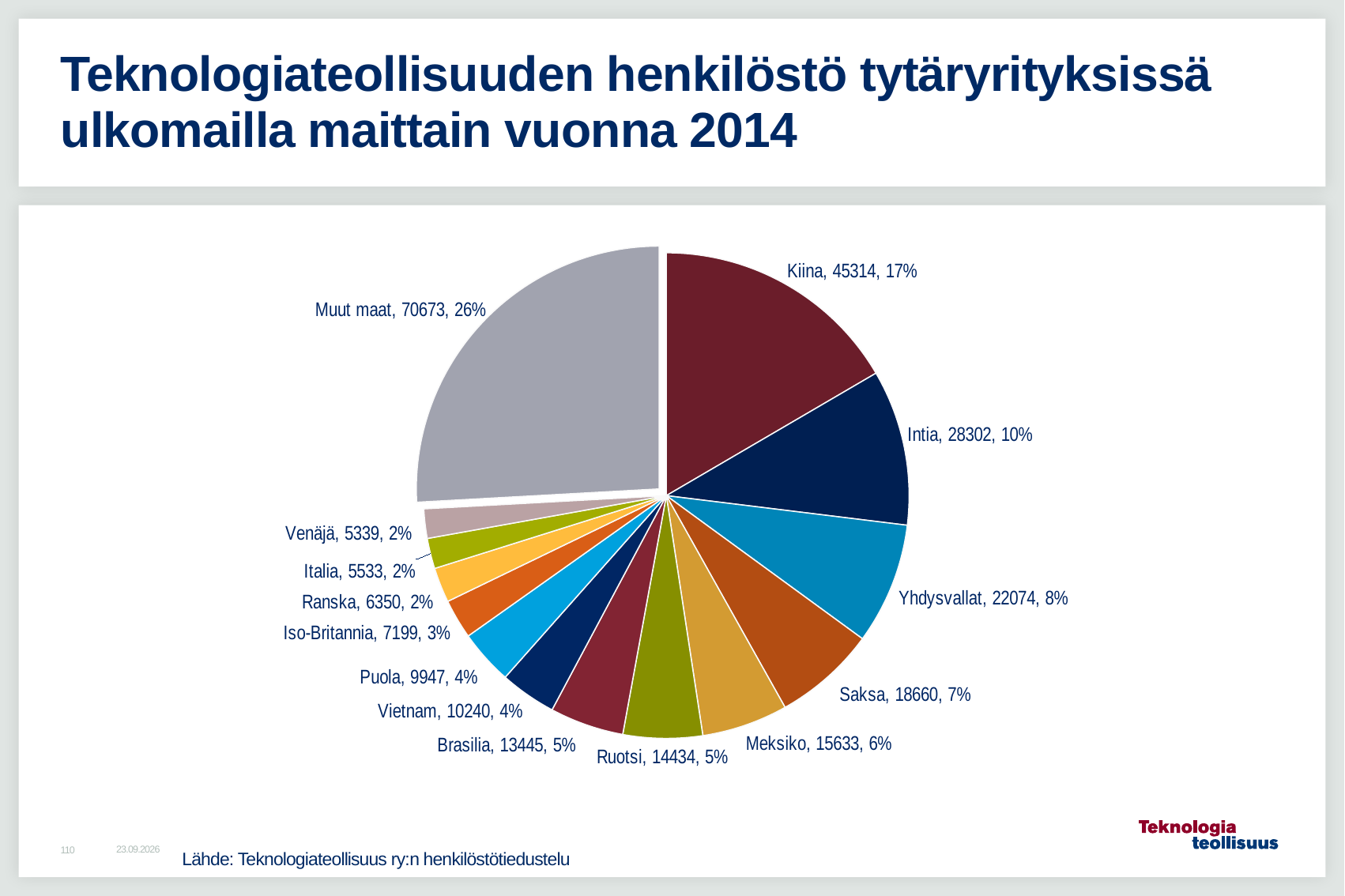
What kind of chart is shown on the slide? pie chart What is the value shown for Yhdysvallat? 22074 What is the value shown for Kiina? 45314 How many slices does the pie chart have? 14 What is the difference between the values for Kiina and Intia? 17012 Which has a larger value, Saksa or Meksiko? Saksa What is the difference between the values for Vietnam and Puola? 293 Which slice has the smallest value in the pie chart? Venäjä What is the title of the chart on the slide? Teknologiateollisuuden henkilöstö tytäryrityksissä ulkomailla maittain vuonna 2014 What share of the pie does Intia represent? 10% What share of the pie does Muut maat represent? 26% Which slice is the largest in the pie chart? Muut maat